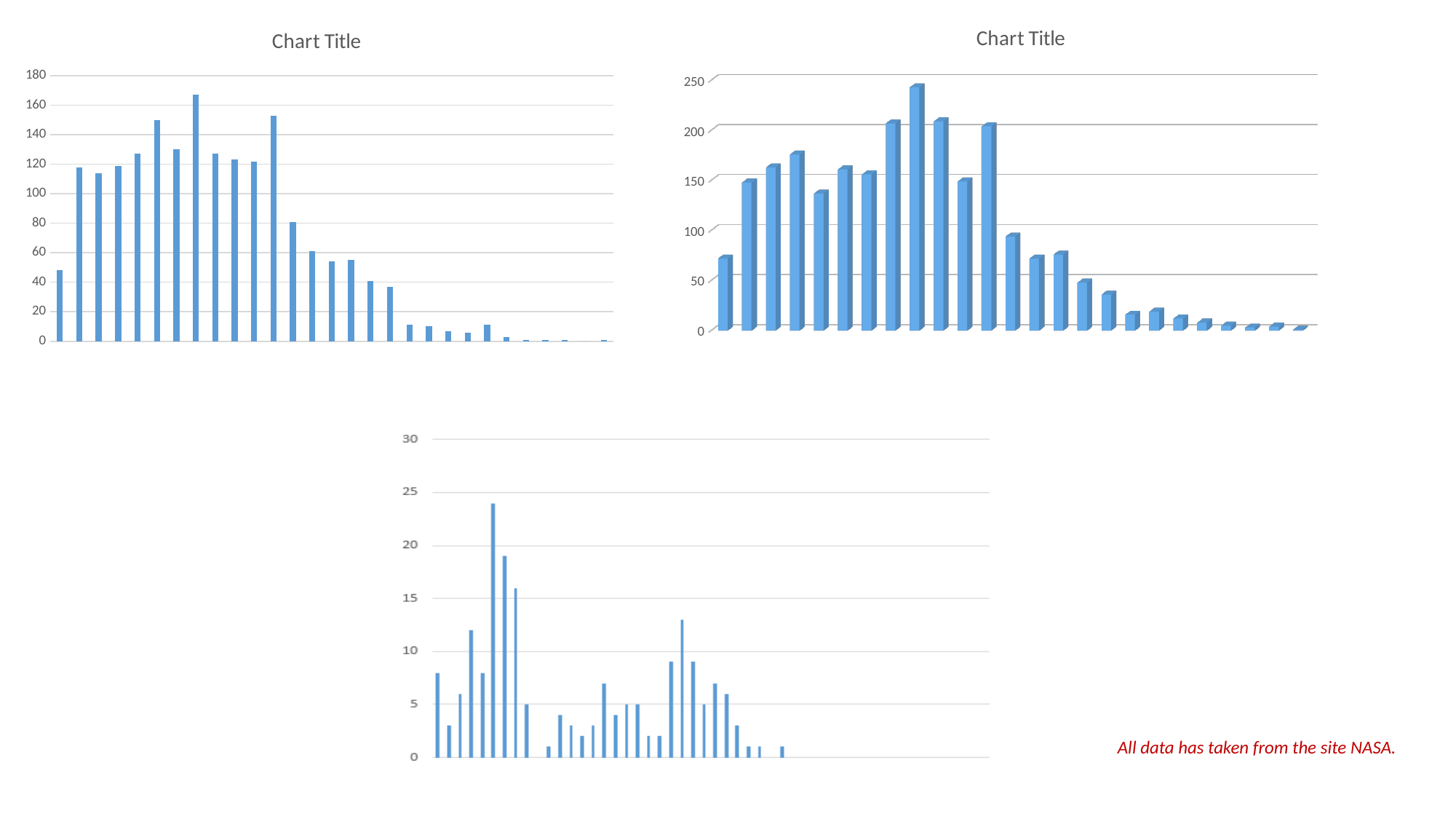
In the top-left chart, after the tallest bar, do the values generally rise or fall moving to the right? fall What kind of chart is the top-right chart? bar chart In the top-right chart, is the value of the first (leftmost) bar greater or less than 100? less What kind of chart is the top-left chart? bar chart In the top-left chart, is the value of the tallest bar greater or less than 160? greater What is the title shown above the top-right chart? Chart Title In the top-right chart, is the value of the tallest bar greater or less than 200? greater What kind of chart is the bottom chart? bar chart In the top-left chart, which is taller, the first bar or the second bar? the second bar What is the highest tick value on the vertical axis of the bottom chart? 30